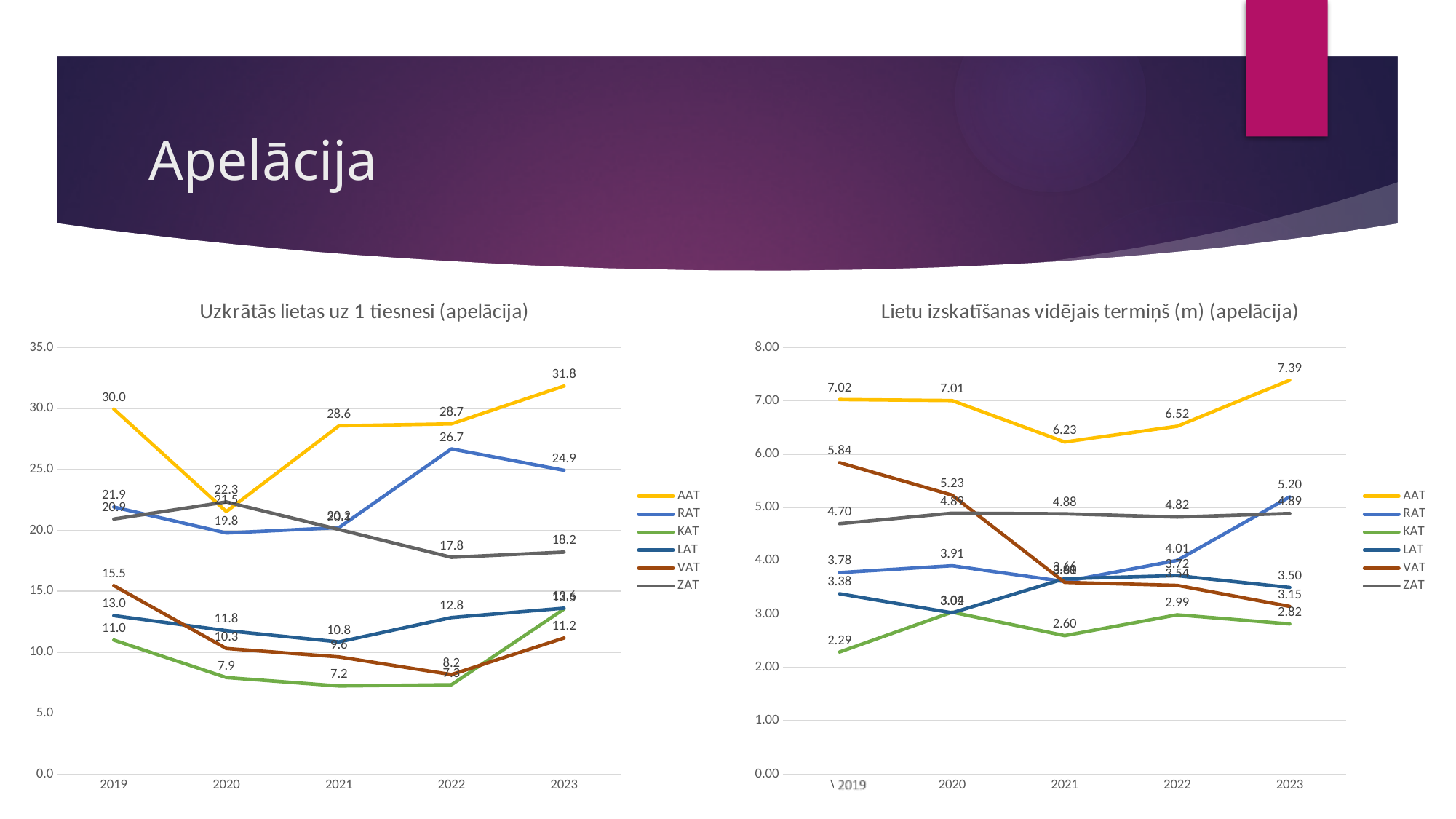
On the chart 'Lietu izskatīšanas vidējais termiņš (m) (apelācija)', which series has the lowest value in 2019? KAT What kind of chart is 'Lietu izskatīšanas vidējais termiņš (m) (apelācija)'? line chart On the chart 'Uzkrātās lietas uz 1 tiesnesi (apelācija)', what is the value for RAT in 2022? 26.7 On the chart 'Lietu izskatīšanas vidējais termiņš (m) (apelācija)', what is the value for AAT in 2021? 6.23 On the chart 'Uzkrātās lietas uz 1 tiesnesi (apelācija)', what is the value for AAT in 2023? 31.8 On the chart 'Uzkrātās lietas uz 1 tiesnesi (apelācija)', how many series does the legend list? 6 On the chart 'Lietu izskatīšanas vidējais termiņš (m) (apelācija)', does the VAT line rise or fall from 2019 to 2023? fall On the chart 'Uzkrātās lietas uz 1 tiesnesi (apelācija)', what is the difference between the AAT values in 2019 and 2020? 8.5 On the chart 'Uzkrātās lietas uz 1 tiesnesi (apelācija)', which series has the highest value in 2019? AAT On the chart 'Lietu izskatīšanas vidējais termiņš (m) (apelācija)', what is the value for VAT in 2019? 5.84 On the chart 'Lietu izskatīšanas vidējais termiņš (m) (apelācija)', what is the difference between the RAT values in 2023 and 2022? 1.19 On the chart 'Uzkrātās lietas uz 1 tiesnesi (apelācija)', which is larger in 2020: ZAT or RAT? ZAT